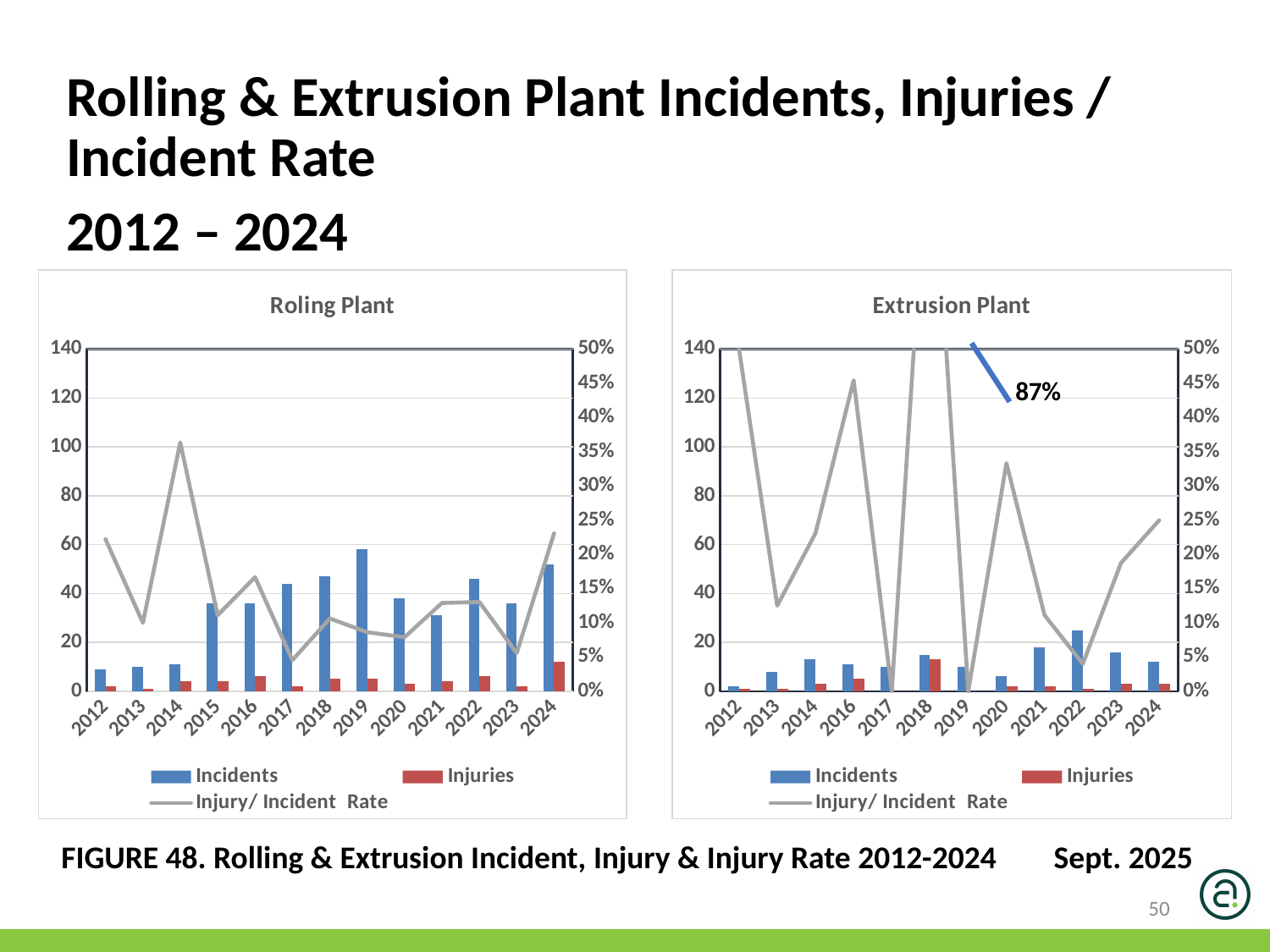
In the Roling Plant chart, is the Injury/Incident Rate in 2014 greater or less than 30%? greater In the Roling Plant chart, which year has the highest number of Incidents? 2019 In the Roling Plant chart, which year has the highest number of Injuries? 2024 What percentage value is annotated near the top of the Extrusion Plant chart? 87% How many years are shown on the x axis of the Extrusion Plant chart? 12 In the Extrusion Plant chart, is the number of Incidents in 2022 greater or less than 20? greater In the Roling Plant chart, which year has the highest Injury/Incident Rate? 2014 In the Roling Plant chart, is the number of Incidents in 2019 greater or less than 40? greater How many series does the legend of the Roling Plant chart list? 3 In the Roling Plant chart, are there more Incidents in 2019 or in 2024? 2019